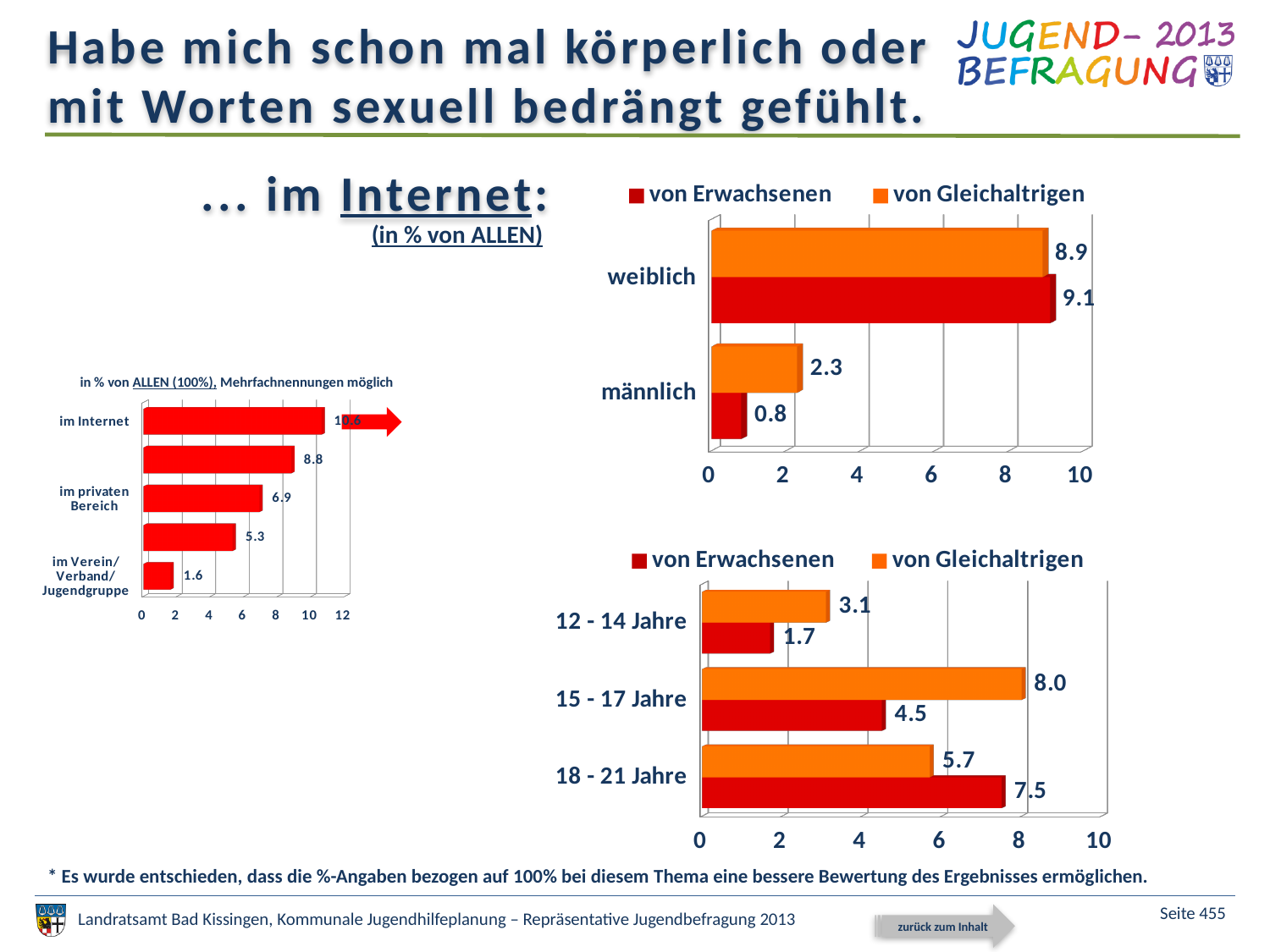
In the bottom-right chart (by age), what is the value for 15 - 17 Jahre in the series 'von Gleichaltrigen'? 8.0 In the bottom-right chart (by age), which age group has the lowest value in the series 'von Gleichaltrigen'? 12 - 14 Jahre How many series does the legend of the top-right chart (by gender) list? 2 In the bottom-right chart (by age), which age group has the highest value in the series 'von Erwachsenen'? 18 - 21 Jahre In the top-right chart (by gender), which is larger for männlich: 'von Erwachsenen' or 'von Gleichaltrigen'? von Gleichaltrigen What kind of chart is the small chart on the left? bar chart In the bottom-right chart (by age), what is the difference between the 'von Erwachsenen' and 'von Gleichaltrigen' values for 18 - 21 Jahre? 1.8 In the top-right chart (by gender), what is the value for weiblich in the series 'von Erwachsenen'? 9.1 In the small chart on the left, what is the value for 'im Internet'? 10.6 In the top-right chart (by gender), what is the difference between the 'von Gleichaltrigen' values for weiblich and männlich? 6.6 How many age groups are shown in the bottom-right chart (by age)? 3 In the top-right chart (by gender), what is the value for männlich in the series 'von Gleichaltrigen'? 2.3